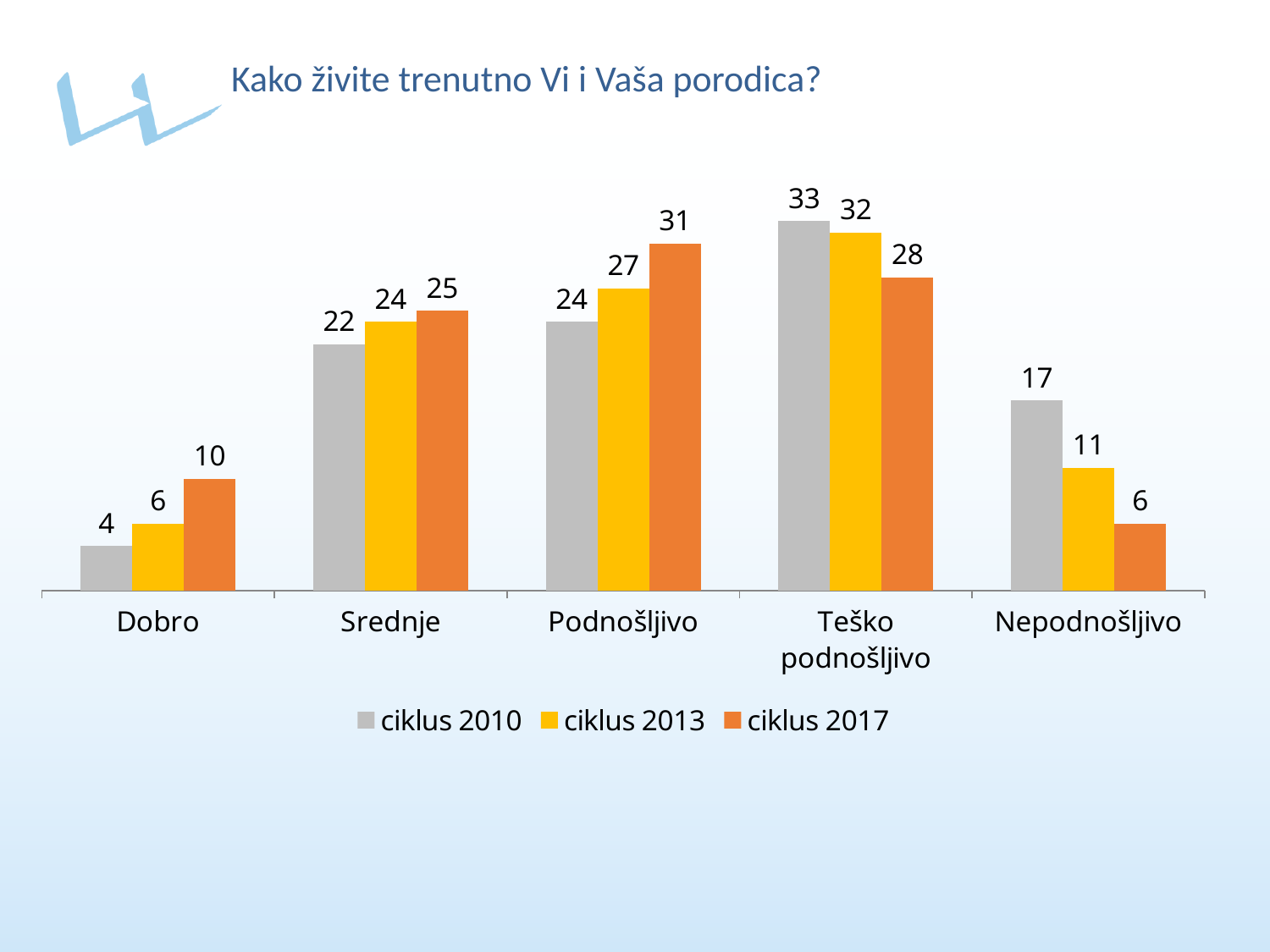
What is the value for Dobro in the ciklus 2017 series? 10 How many categories are shown on the x axis? 5 What is the title of the slide? Kako živite trenutno Vi i Vaša porodica? What kind of chart is shown on the slide? bar chart What is the difference between the ciklus 2010 and ciklus 2017 values for Nepodnošljivo? 11 How many series does the legend list? 3 What is the difference between the ciklus 2017 and ciklus 2010 values for Podnošljivo? 7 What is the value for Teško podnošljivo in the ciklus 2010 series? 33 What is the value for Nepodnošljivo in the ciklus 2013 series? 11 Which is larger for Srednje: the ciklus 2010 value or the ciklus 2017 value? ciklus 2017 Which category has the highest value in the ciklus 2017 series? Podnošljivo Which category has the lowest value in the ciklus 2010 series? Dobro